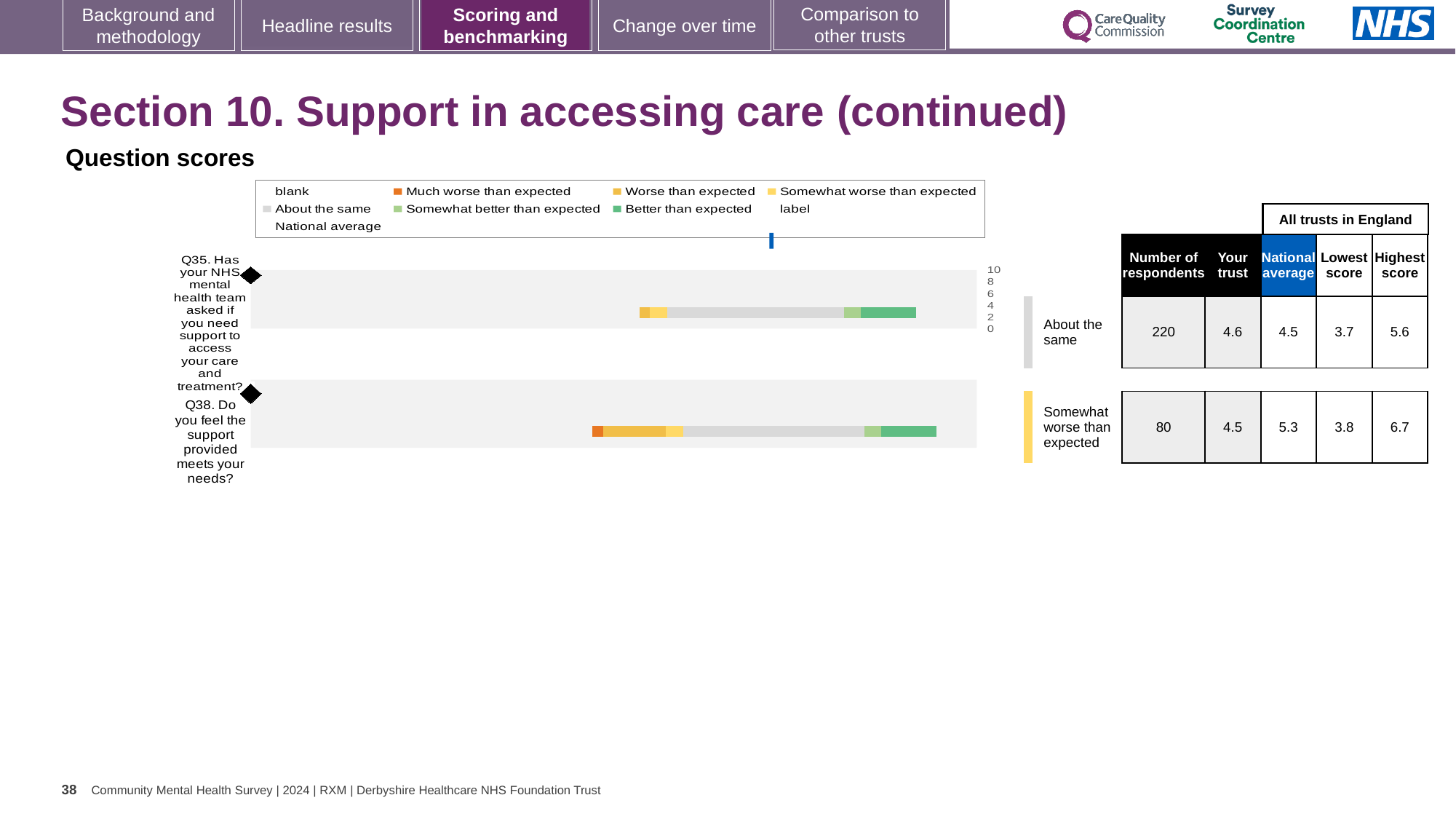
How many respondents answered Q35? 220 Which benchmark category is the trust's Q38 score placed in? Somewhat worse than expected What is the 'Your trust' score for Q35 (Has your NHS mental health team asked if you need support to access your care and treatment?)? 4.6 What is the 'Your trust' score for Q38 (Do you feel the support provided meets your needs?)? 4.5 For Q35, what is the difference between the highest and lowest scores among all trusts in England? 1.9 For Q38, what is the difference between the national average and the trust's score? 0.8 What is the highest score among all trusts in England for Q38? 6.7 What kind of chart is used to show the question scores on this slide? bar chart How many questions are plotted in the question scores chart? 2 What is the national average score for Q38? 5.3 What is the national average score for Q35? 4.5 For Q38, which is larger: the trust's score or the national average? National average